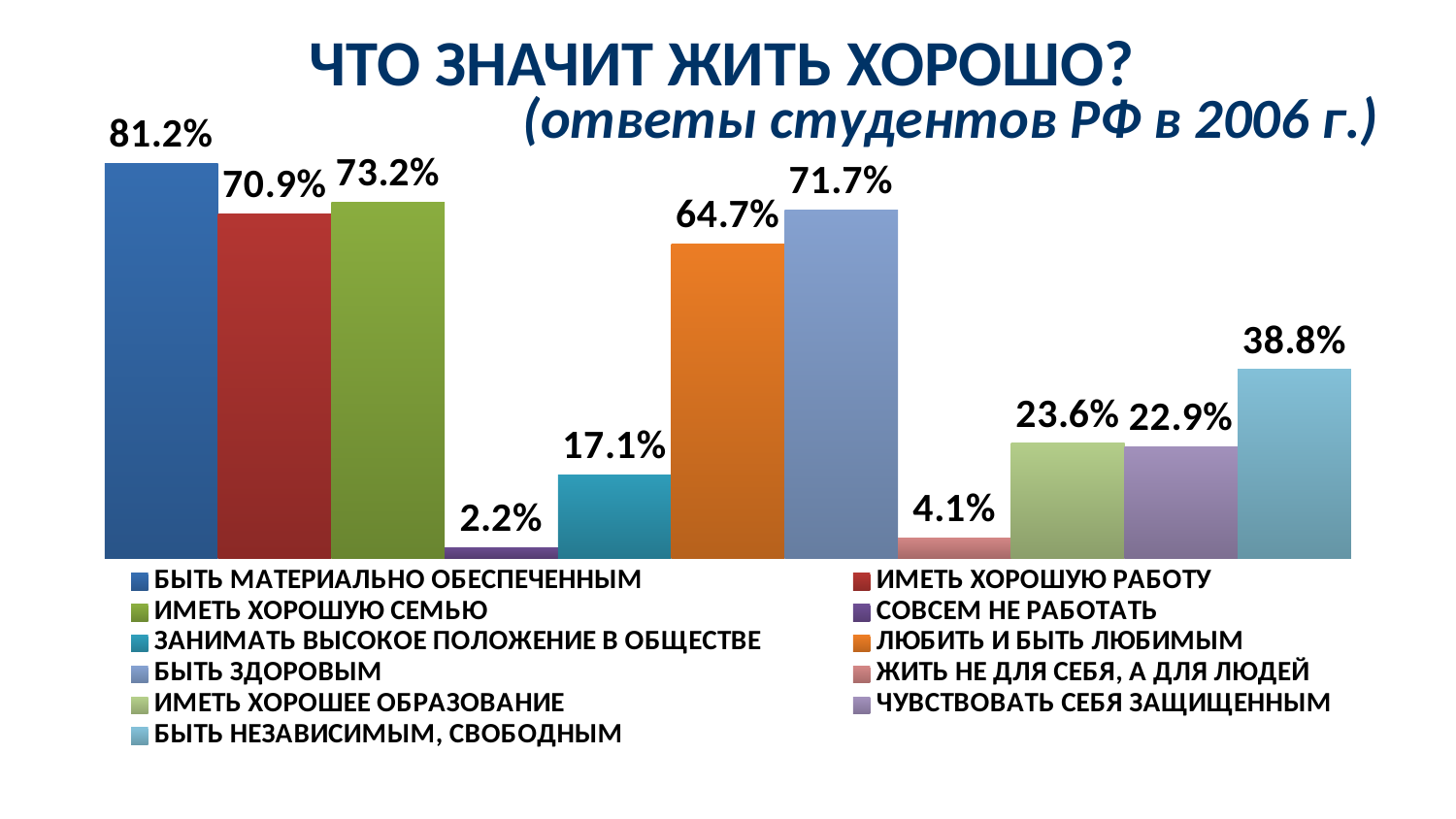
What is the value for «Быть материально обеспеченным»? 81.2% What kind of chart is shown on the slide? Bar chart Which is larger: «Быть независимым, свободным» or «Иметь хорошее образование»? Быть независимым, свободным Which category has the highest value? Быть материально обеспеченным What is the value for «Любить и быть любимым»? 64.7% Which category has the lowest value? Совсем не работать How many entries does the legend list? 11 What is the value for «Быть независимым, свободным»? 38.8% What is the value for «Совсем не работать»? 2.2% What is the difference between «Быть здоровым» and «Любить и быть любимым»? 7.0% How many bars are plotted on the chart? 11 Which is larger: «Иметь хорошую семью» or «Иметь хорошую работу»? Иметь хорошую семью